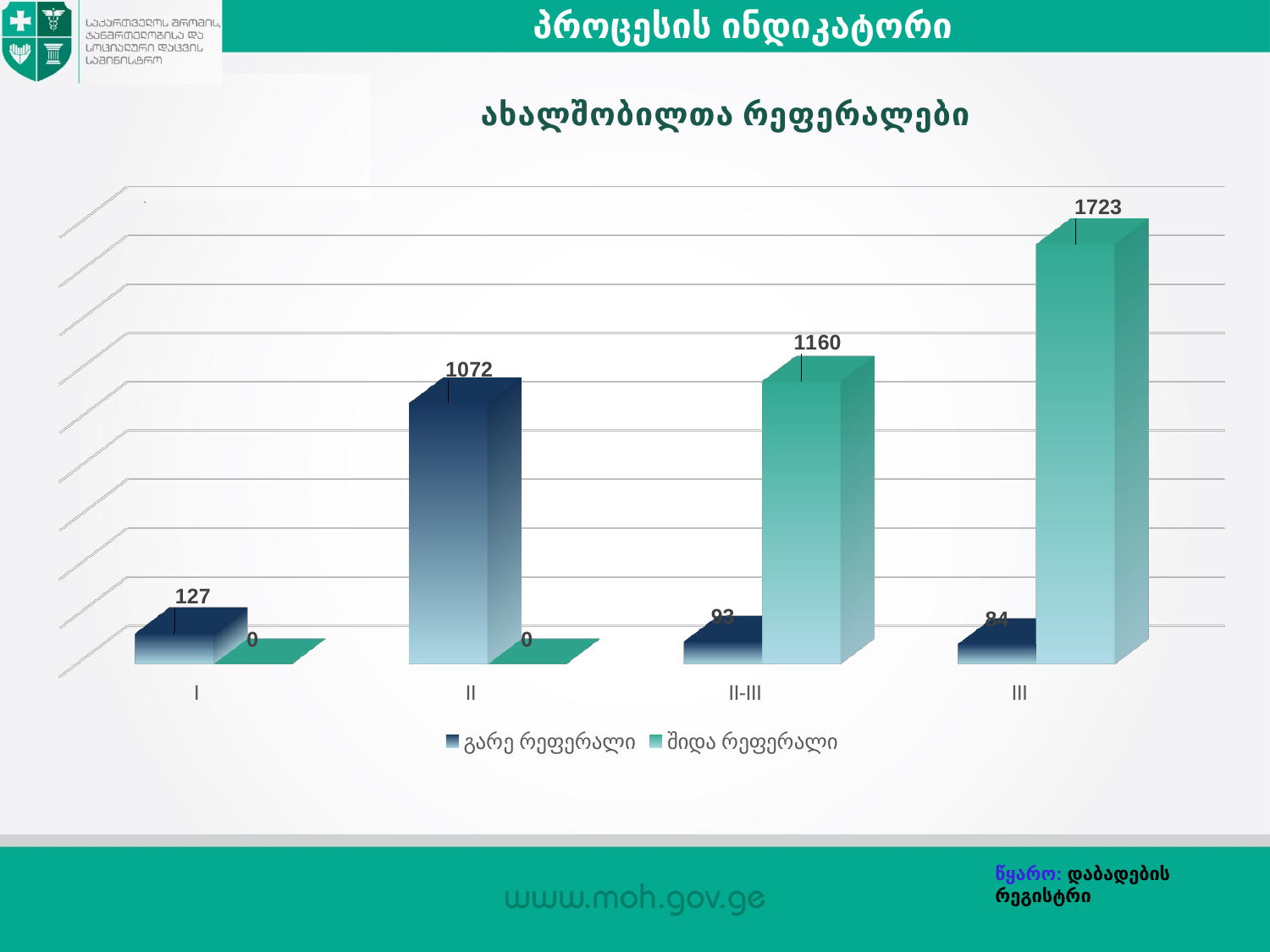
How many series does the legend list? 2 What is the value of გარე რეფერალი for category II? 1072 What is the value of შიდა რეფერალი for category II-III? 1160 Which category has the highest value for გარე რეფერალი? II What is the value of გარე რეფერალი for category I? 127 What is the value of შიდა რეფერალი for category III? 1723 Which category has the highest value for შიდა რეფერალი? III What is the value of შიდა რეფერალი for category I? 0 What type of chart is shown on the slide? bar chart How many categories are shown on the x axis? 4 Which is larger: გარე რეფერალი for II or შიდა რეფერალი for II-III? შიდა რეფერალი for II-III What is the difference between შიდა რეფერალი for III and for II-III? 563